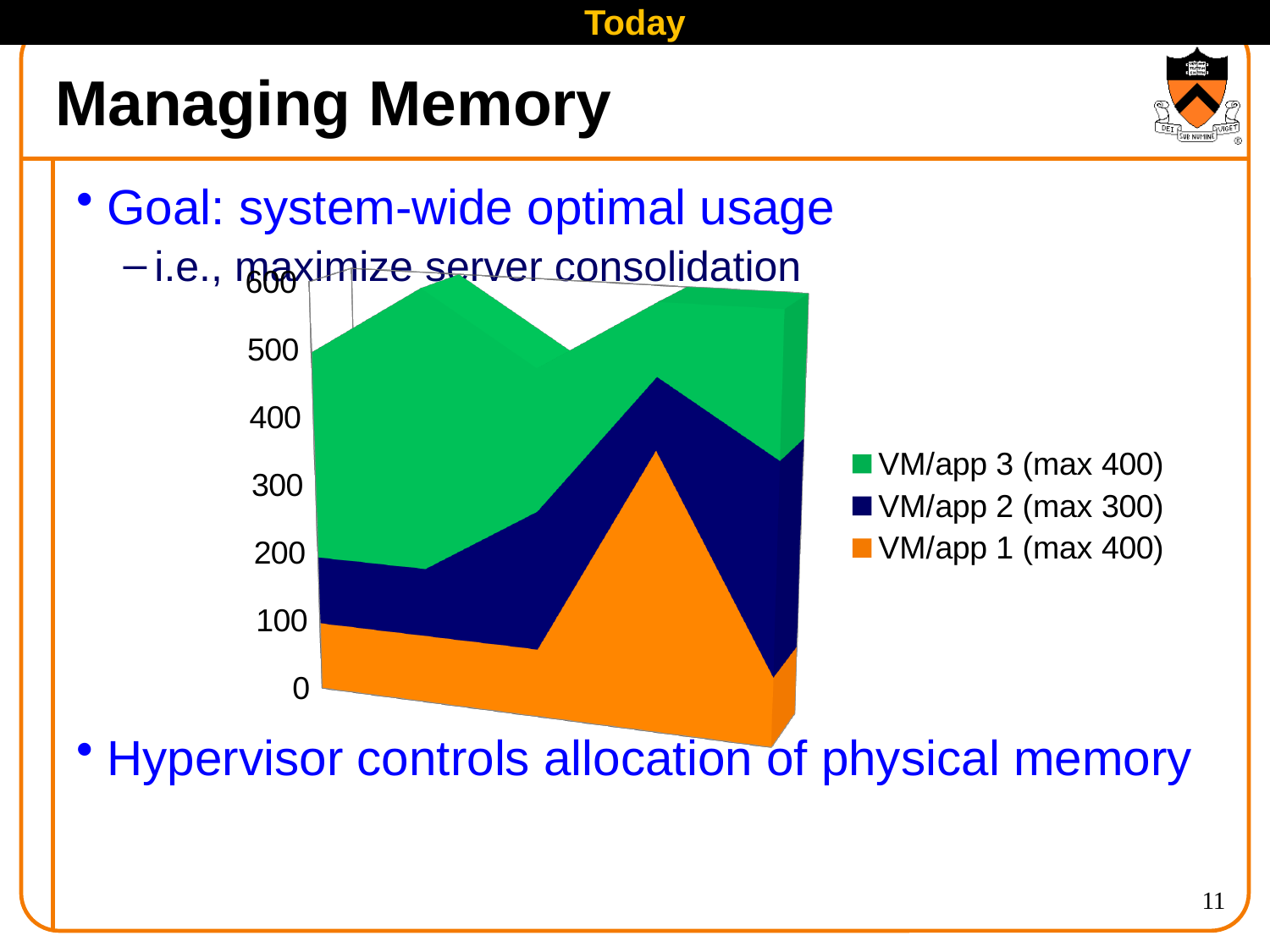
How many data points does each series in the chart have? 5 Which series is shown in orange in the chart? VM/app 1 (max 400) Is the stacked total at the first data point greater or less than 400? greater Is the peak value of VM/app 1 (max 400) greater or less than 300? greater What kind of chart is shown on the slide? area chart Which series is listed first in the chart's legend? VM/app 3 (max 400) How many series does the legend list? 3